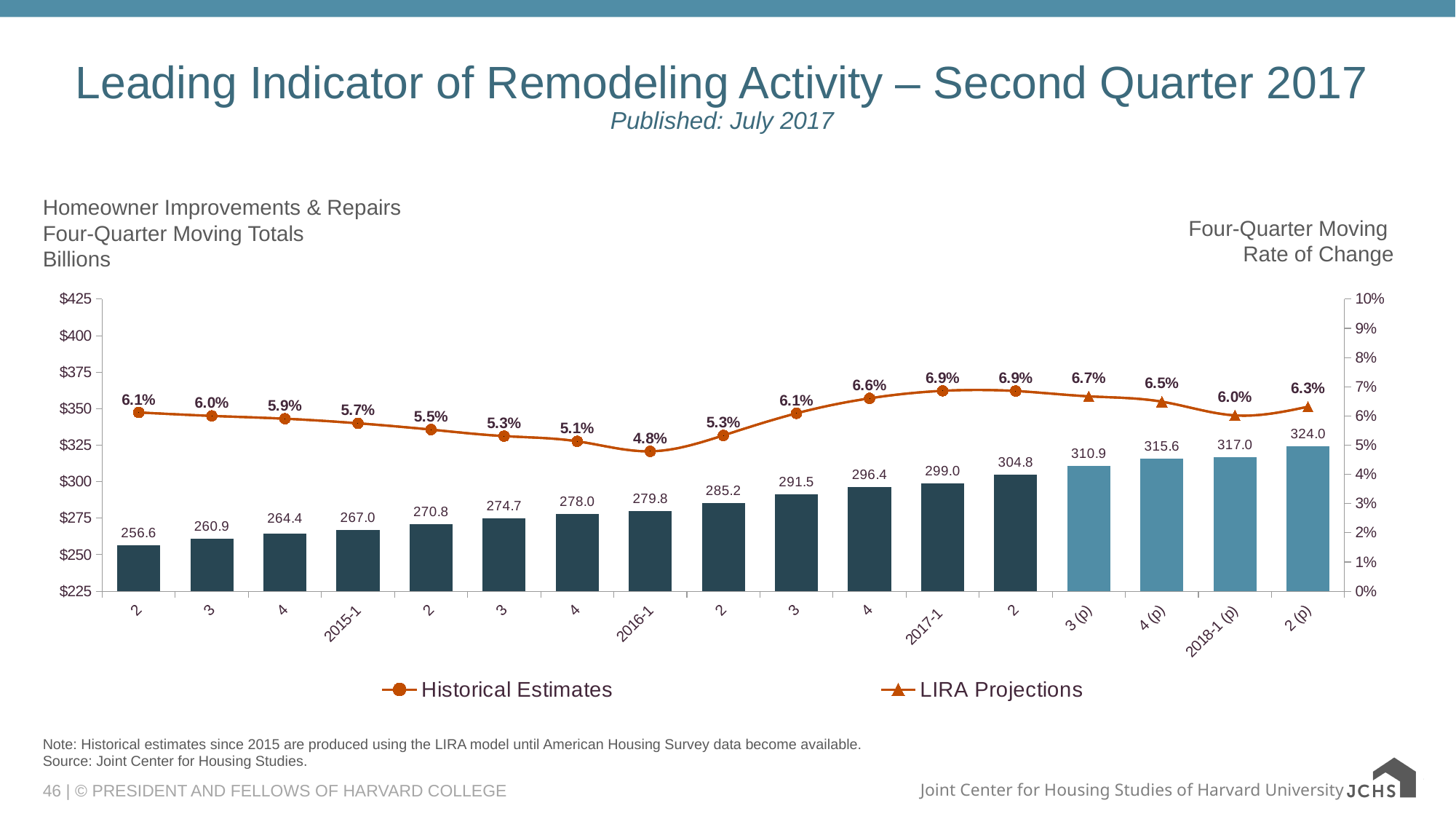
What is the four-quarter moving total for 2017-1? 299.0 How many series does the legend list? 2 What is the difference between the four-quarter moving total for 2 (p) and the first bar (2)? 67.4 What kind of chart is shown on the slide? Combined bar and line chart Which period has the lowest four-quarter moving rate of change? 2016-1 Which period has the highest four-quarter moving total? 2 (p) What is the projected four-quarter moving total for 2018-1 (p)? 317.0 Is the four-quarter moving total for 2015-1 greater or less than $275? less What is the four-quarter moving rate of change for 2016-1? 4.8% Do the four-quarter moving totals rise or fall from left to right along the x axis? rise Which is larger, the rate of change for 2017-1 or for 2018-1 (p)? 2017-1 How many bars are plotted on the chart? 17